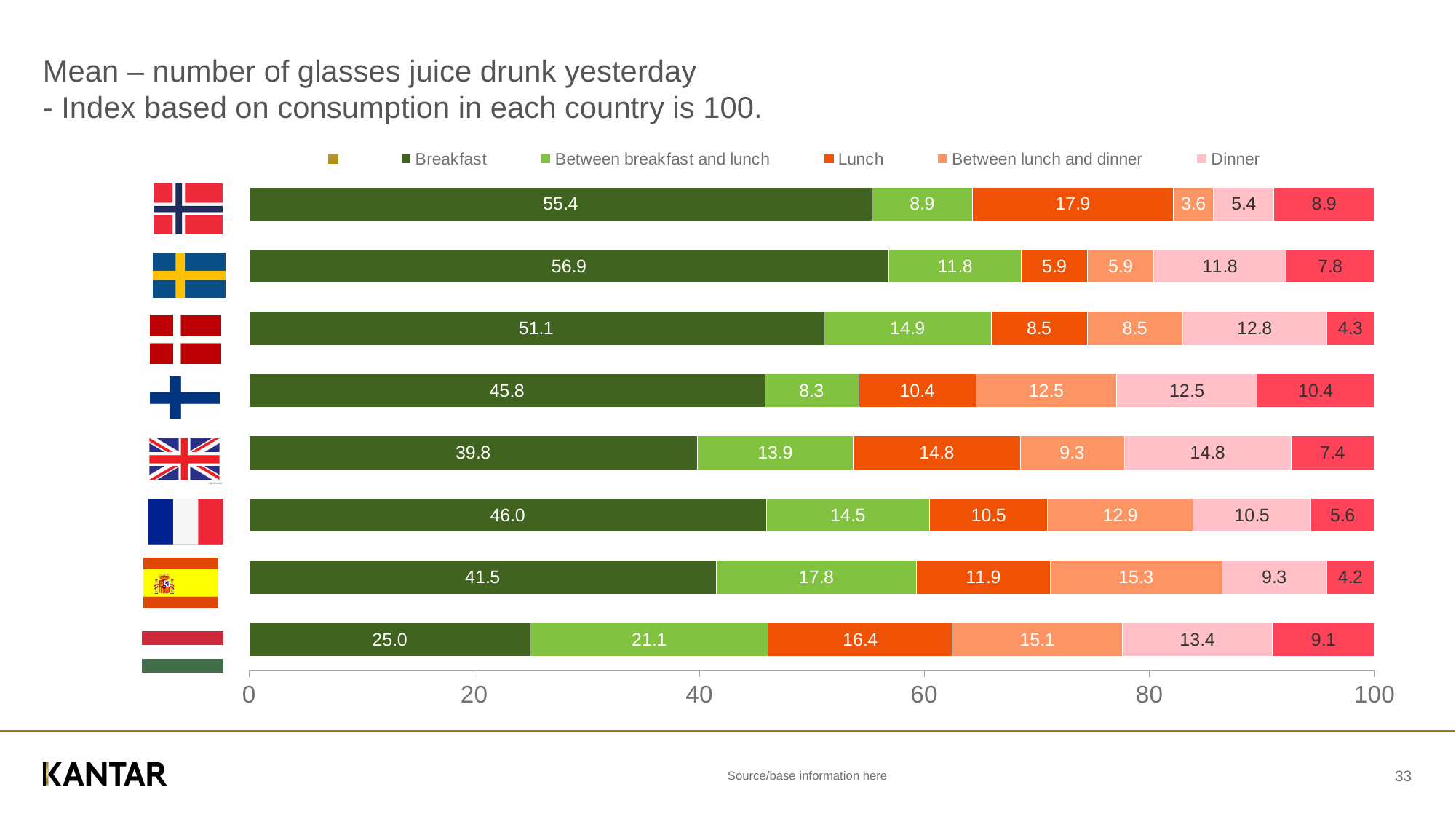
What is the Between lunch and dinner value for the top bar (Norwegian flag)? 3.6 What is the Breakfast value for the top bar (Norwegian flag)? 55.4 What is the Lunch value for the bottom bar (Hungarian flag)? 16.4 What is the Between breakfast and lunch value for the bottom bar (Hungarian flag)? 21.1 What is the difference between the Breakfast value of the top bar (55.4) and the bottom bar (25.0)? 30.4 Which bar has the lowest Breakfast value? the bottom bar (Hungarian flag), 25.0 Which has the larger Lunch value: the top bar (Norwegian flag) or the bottom bar (Hungarian flag)? the top bar (Norwegian flag), 17.9 What kind of chart is shown on the slide? bar chart Which bar has the highest Breakfast value? the second bar from the top (Swedish flag), 56.9 What is the Dinner value for the fourth bar from the top (Finnish flag)? 12.5 What colour represents the Breakfast series in the legend? dark green How many bars (countries) are plotted in the chart? 8